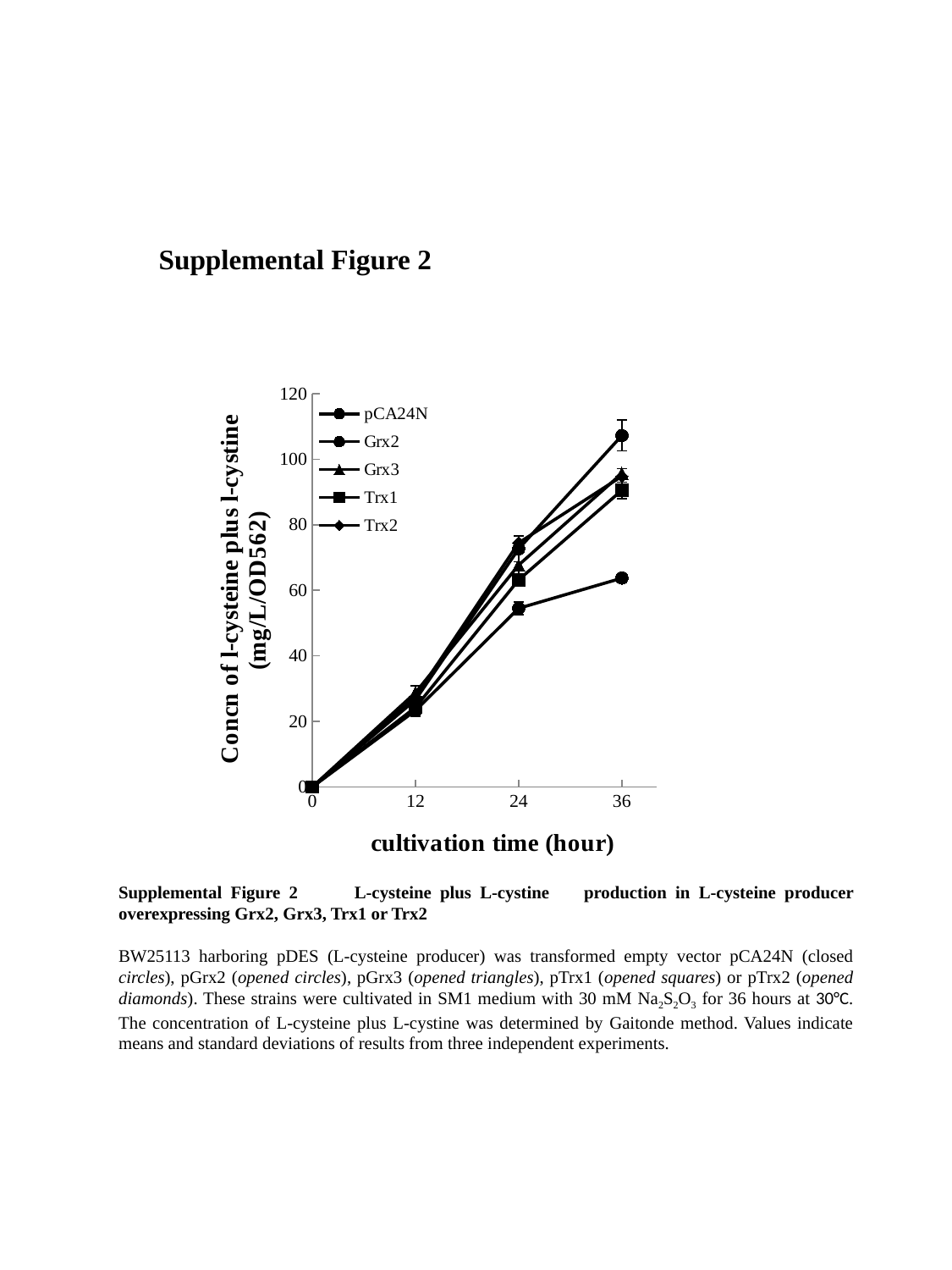
Is the value for Grx3 at 24 hours greater or less than 80? less Is the value for Grx3 at 36 hours greater or less than 80? greater Is the highest value plotted at 36 hours greater or less than 100? greater What kind of chart is shown on the slide? line chart Do the values for Trx1 rise or fall from 0 to 36 hours? rise How many series does the legend list? 5 Do the values for Grx3 rise or fall as cultivation time increases? rise What is the label of the x axis? cultivation time (hour) How many time points are marked on the x axis? 4 What is the maximum value shown on the y axis? 120